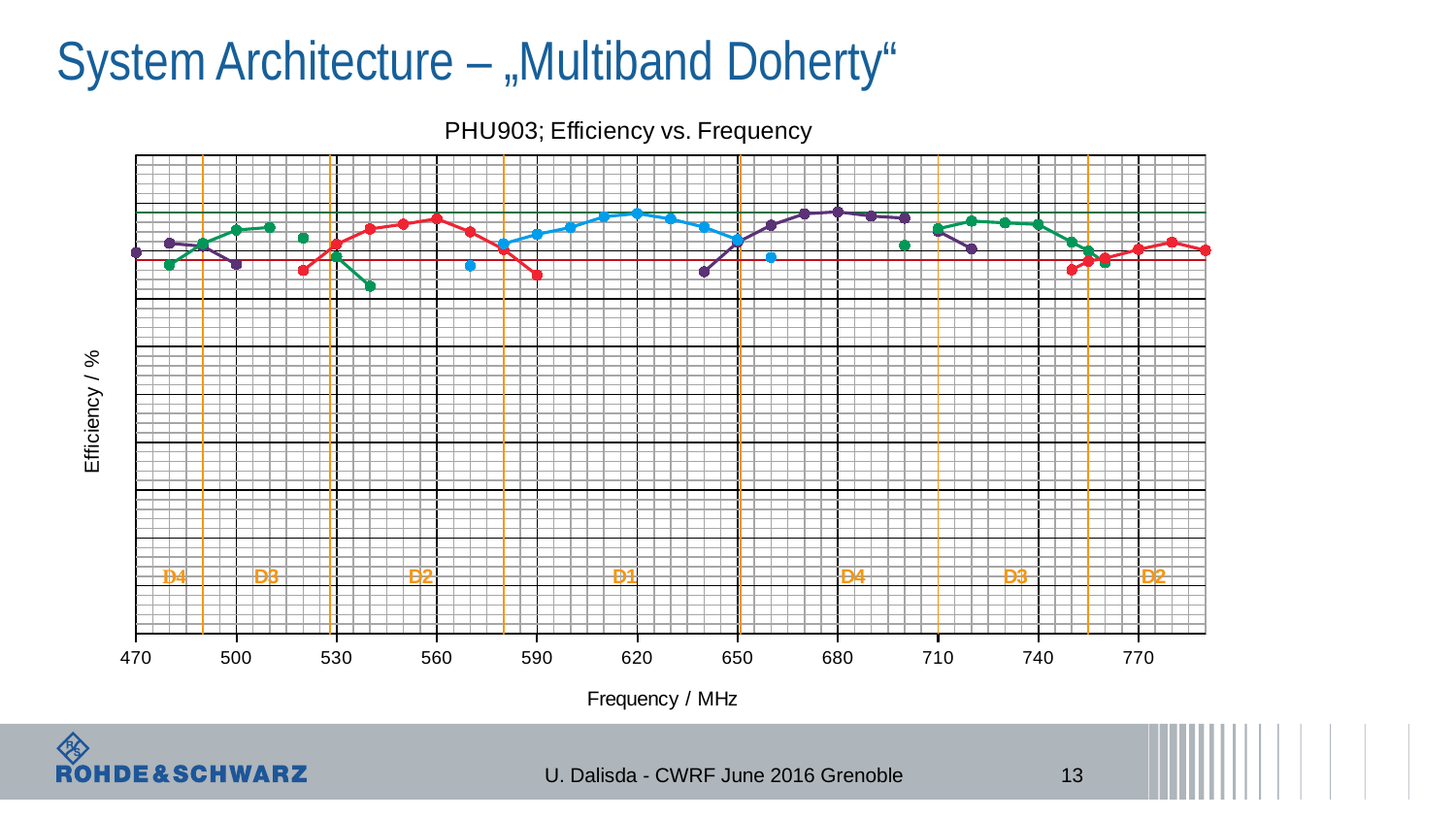
What is the label of the x axis of the chart? Frequency / MHz What kind of chart is shown on the slide? line chart What is the title of the chart? PHU903; Efficiency vs. Frequency What is the spacing between consecutive tick labels on the x axis? 30 What is the highest frequency value labelled on the x axis? 770 What is the lowest frequency value labelled on the x axis? 470 How many band labels (D1, D2, D3, D4) are printed along the bottom of the plot area? 7 How many tick labels are printed along the x axis? 11 Which band label appears between the x-axis values 590 and 650? D1